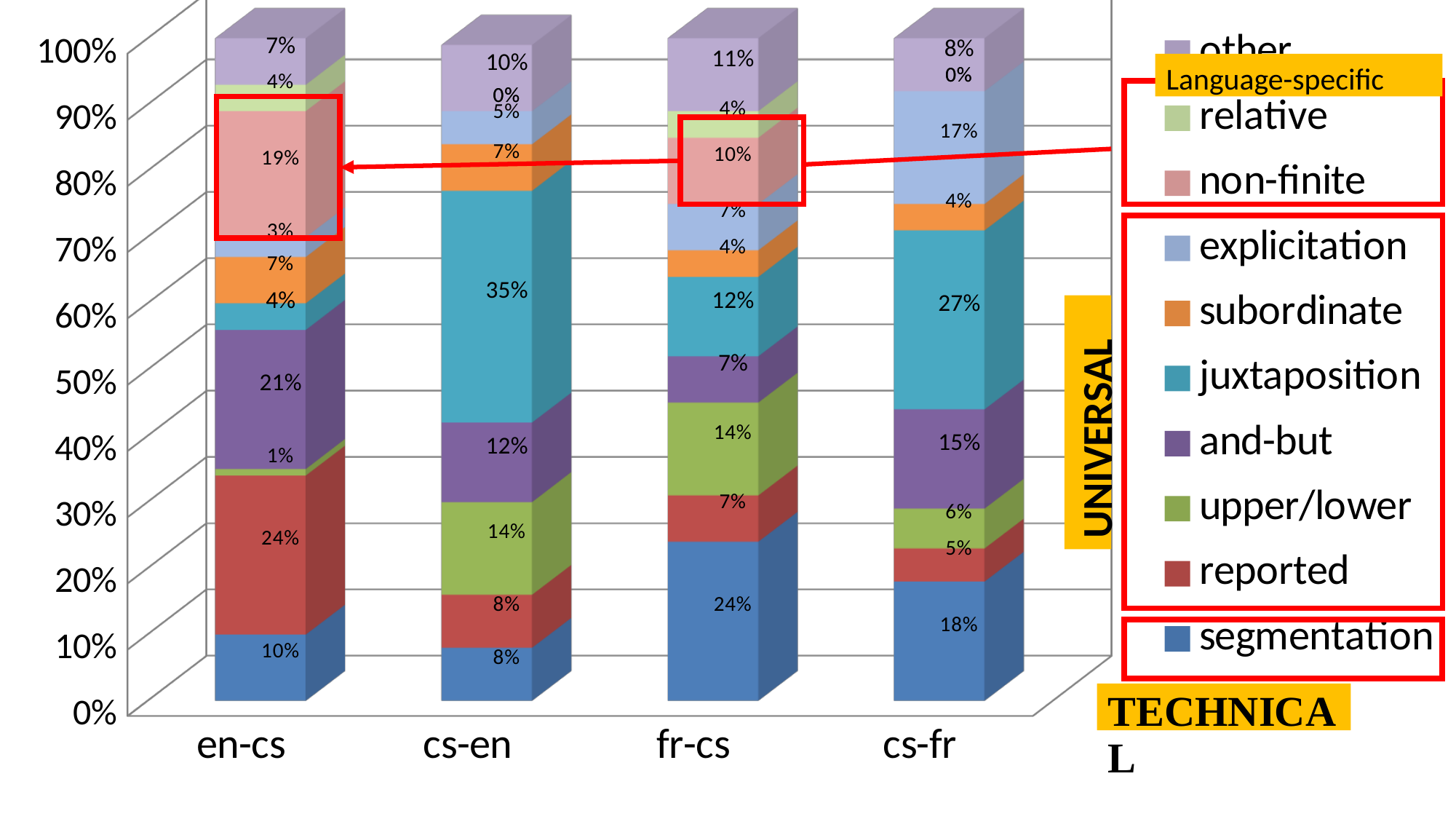
By how many percentage points does the juxtaposition share for cs-en exceed that for cs-fr? 8 What is the segmentation share for fr-cs? 24% Which series is listed at the bottom of the legend? segmentation How many series does the legend list? 10 Which language pair has the highest segmentation share? fr-cs Which language pair has the lowest juxtaposition share? en-cs Which has a larger reported share, en-cs or cs-fr? en-cs How many language-pair categories are shown on the x axis? 4 What is the juxtaposition share for cs-en? 35% What kind of chart is shown on the slide? stacked bar chart What is the non-finite share for en-cs? 19% What is the explicitation share for cs-fr? 17%